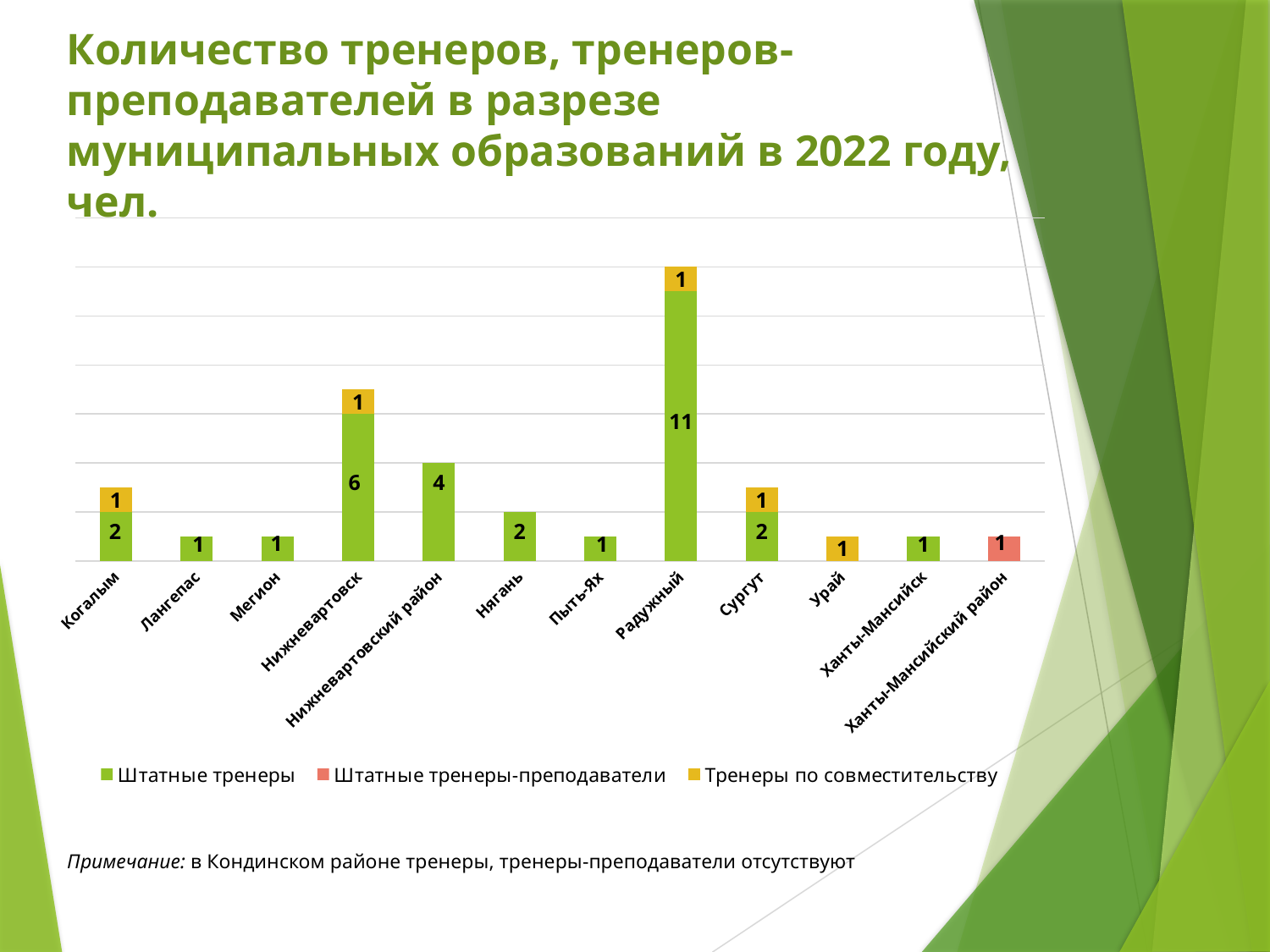
How many series does the legend list? 3 What is the value of Штатные тренеры for Нижневартовский район? 4 What is the total of the stacked bar for Нижневартовск? 7 What is the total of the stacked bar for Радужный? 12 Which is larger: Штатные тренеры for Нижневартовский район or for Сургут? Нижневартовский район What is the difference between Штатные тренеры for Радужный and for Нижневартовск? 5 How many municipalities (categories) are shown on the x axis? 12 What type of chart is shown on the slide? Stacked bar chart What is the value of Штатные тренеры for Нижневартовск? 6 Which municipality is the only one with a value for Штатные тренеры-преподаватели? Ханты-Мансийский район Which municipality has the highest total number of trainers? Радужный What is the value of Штатные тренеры for Радужный? 11